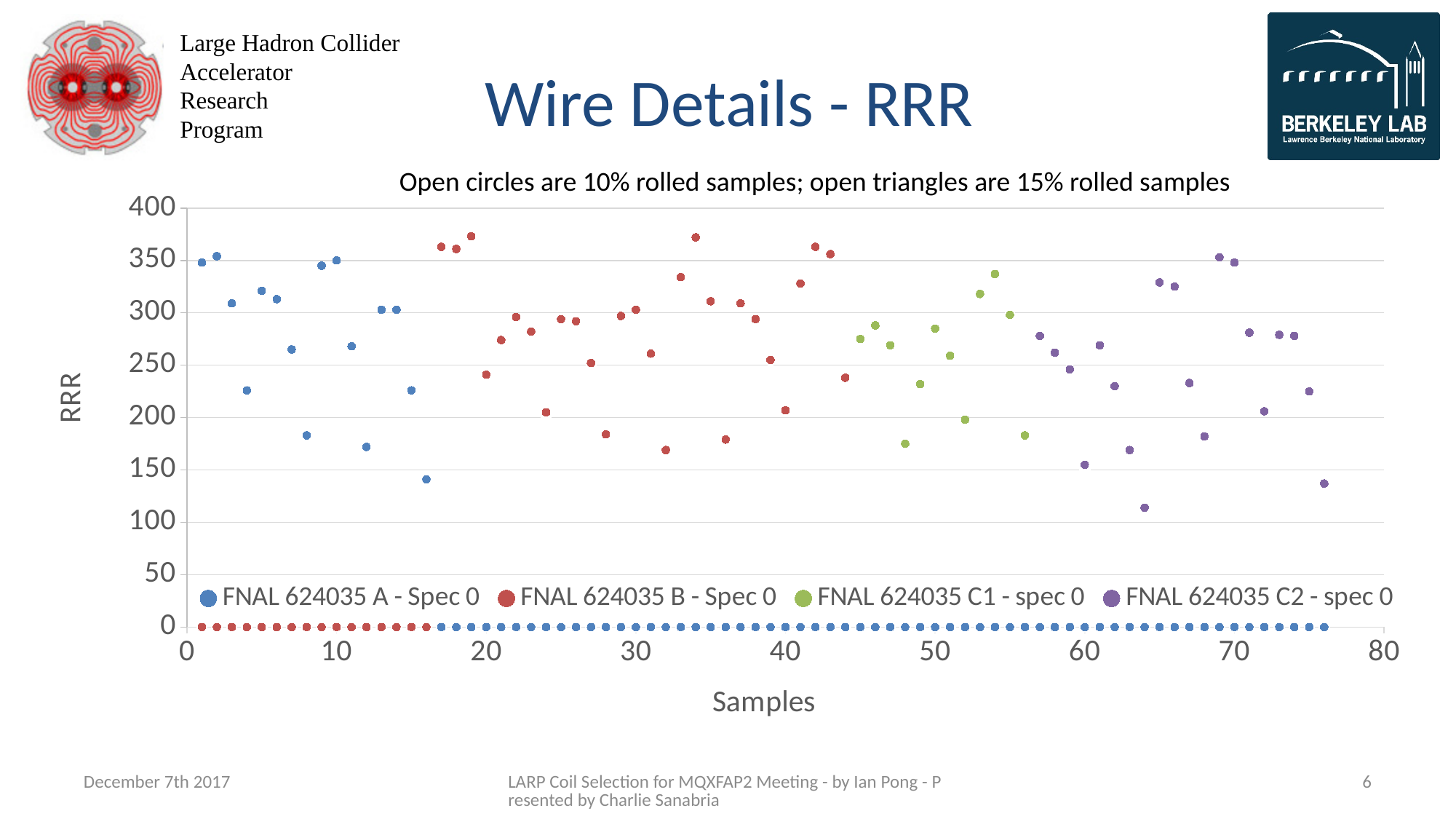
What is the highest value shown on the y axis? 400 Is the RRR value for sample 1 greater or less than 300? greater How many series does the legend list? 4 Which series contains the lowest RRR value plotted on the chart? FNAL 624035 C2 - spec 0 What kind of chart is shown on the slide? scatter chart Is the RRR value for sample 16 greater or less than 200? less Is the RRR value for sample 76 greater or less than 200? less Which is larger, the RRR value for sample 1 or the RRR value for sample 16? sample 1 What is the label on the y axis? RRR